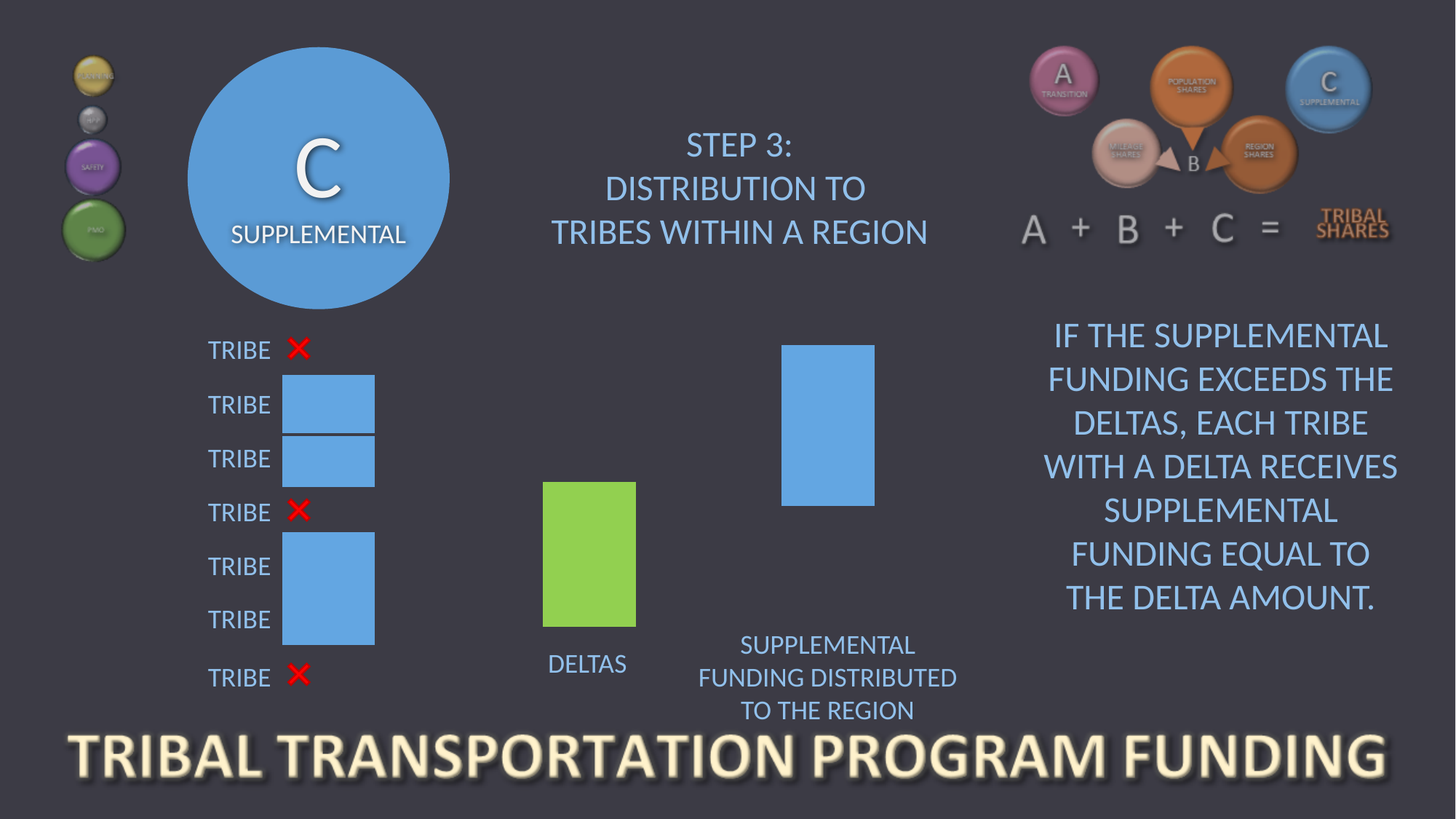
In the diagram comparing DELTAS and SUPPLEMENTAL FUNDING DISTRIBUTED TO THE REGION, which bar is taller? SUPPLEMENTAL FUNDING DISTRIBUTED TO THE REGION How many TRIBE rows are listed in the left-hand diagram? 7 What colour is the SUPPLEMENTAL FUNDING DISTRIBUTED TO THE REGION bar? Blue How many TRIBE rows in the left-hand diagram are marked with a red X instead of a bar? 3 What colour is the DELTAS bar? Green How many TRIBE rows in the left-hand diagram have a blue bar? 4